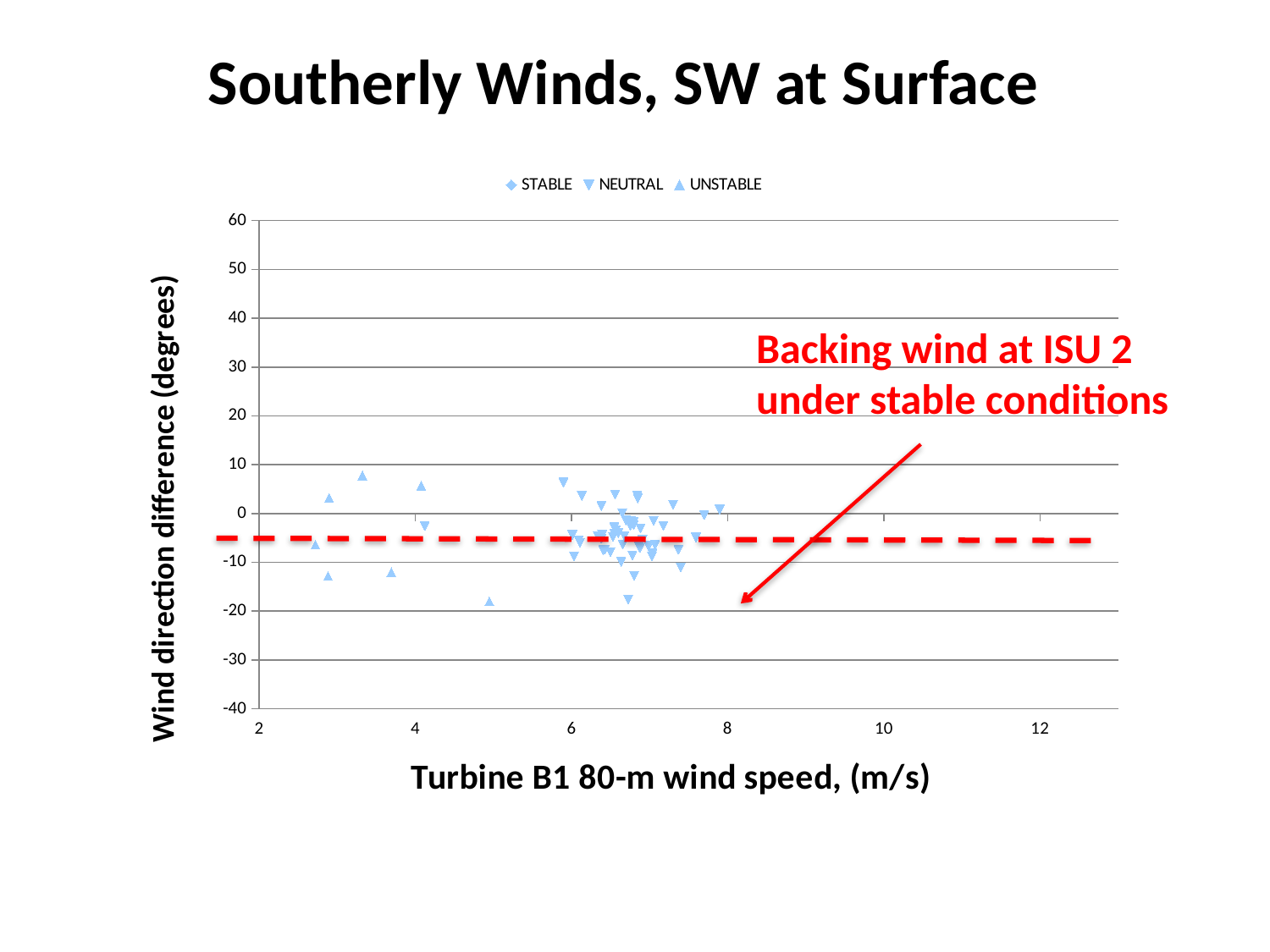
Is the lowest plotted wind direction difference greater or less than -10? less What are the three series named in the legend? STABLE, NEUTRAL, UNSTABLE Is the highest plotted wind direction difference greater or less than 10? less How many series does the legend list? 3 Are any points plotted at a wind speed greater than 10 m/s? No What kind of chart is shown on the slide? scatter chart What is the title of the chart's x axis? Turbine B1 80-m wind speed, (m/s)